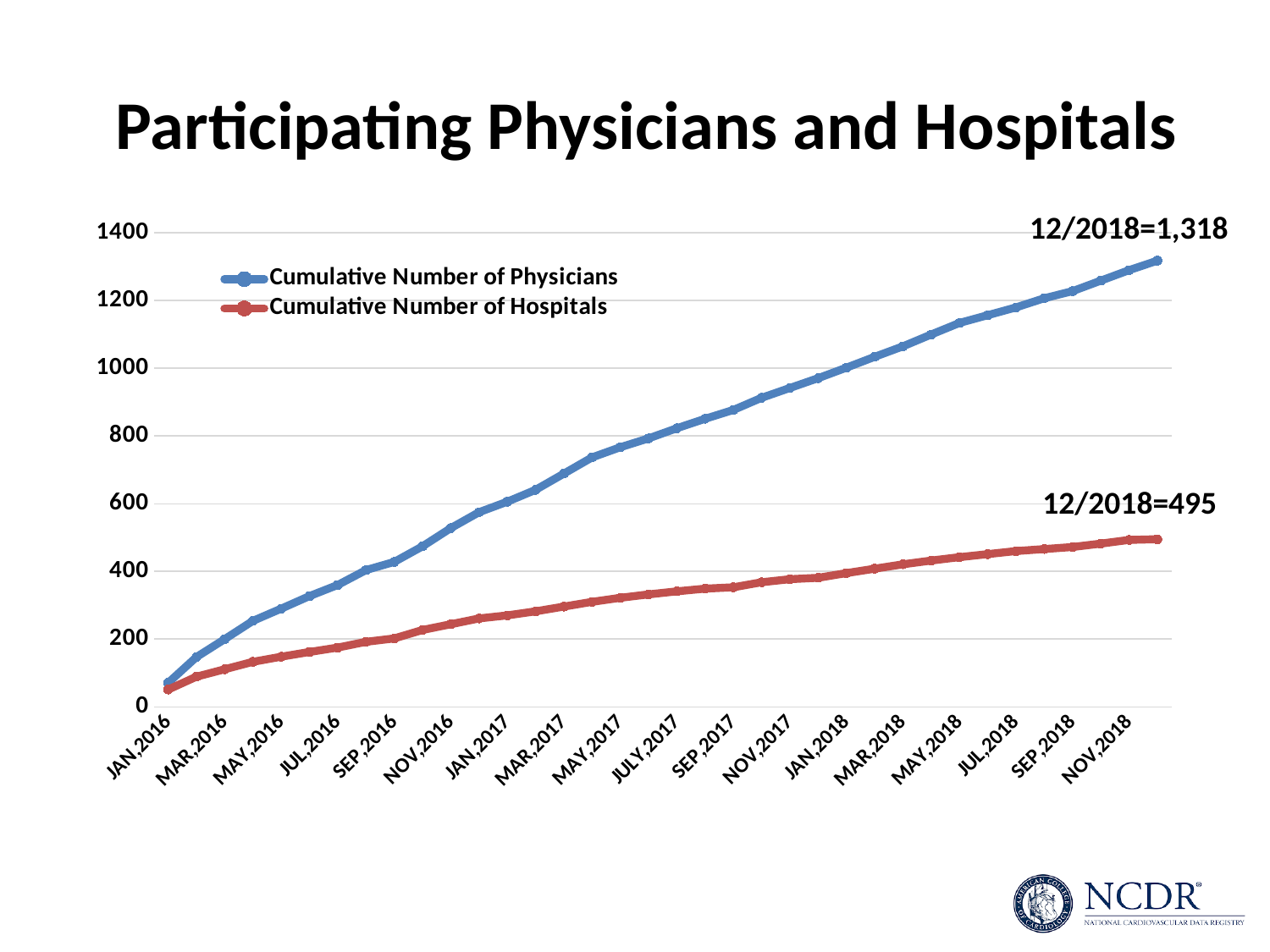
Is the value for Cumulative Number of Physicians at JAN,2017 greater or less than 400? greater What is the title of the chart? Participating Physicians and Hospitals How many series does the legend list? 2 Is the value for Cumulative Number of Hospitals at NOV,2018 greater or less than 400? greater What is the cumulative number of hospitals at 12/2018? 495 What is the difference between the cumulative number of physicians and the cumulative number of hospitals at 12/2018? 823 Which series has the larger value at 12/2018, Cumulative Number of Physicians or Cumulative Number of Hospitals? Cumulative Number of Physicians What kind of chart is shown on the slide? Line chart Do the values for Cumulative Number of Physicians rise or fall from JAN,2016 to NOV,2018? Rise Which colour is used for the Cumulative Number of Hospitals line? Red What is the cumulative number of physicians at 12/2018? 1,318 Is the value for Cumulative Number of Physicians at MAY,2017 greater or less than 800? less